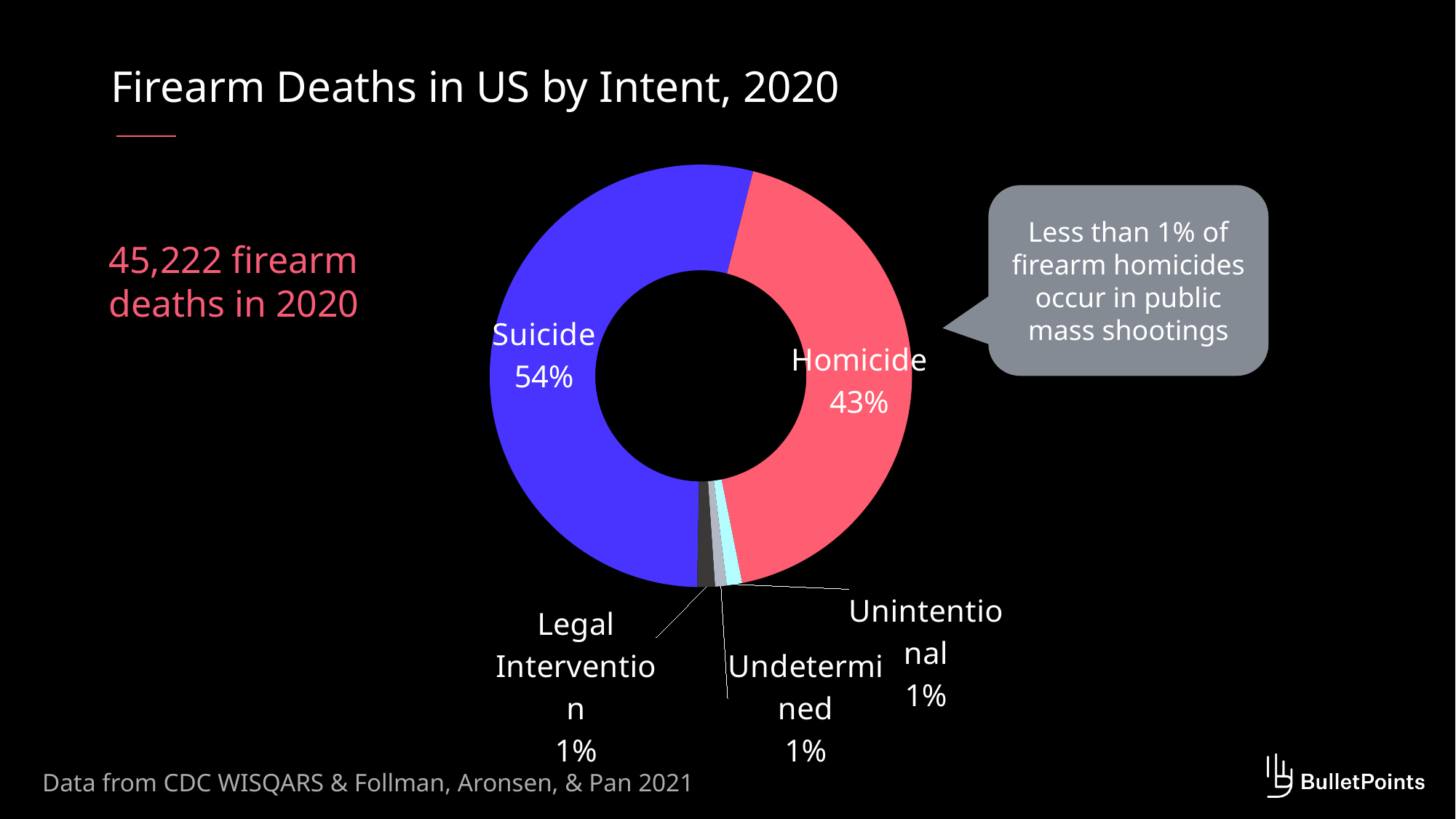
What is the title of the chart on the slide? Firearm Deaths in US by Intent, 2020 Which intent category accounts for the largest share of firearm deaths? Suicide How many total firearm deaths in 2020 does the slide report? 45,222 What is the difference in percentage points between the Suicide and Homicide shares? 11 What percentage is shown for Legal Intervention? 1% What share of firearm deaths is attributed to Homicide? 43% What share of firearm deaths is attributed to Suicide? 54% How many intent categories are shown in the chart? 5 What type of chart is shown on the slide? Pie chart (doughnut) Which is larger, the share for Suicide or the share for Homicide? Suicide What percentage is shown for Unintentional firearm deaths? 1% What colour is the Homicide slice of the chart? Red